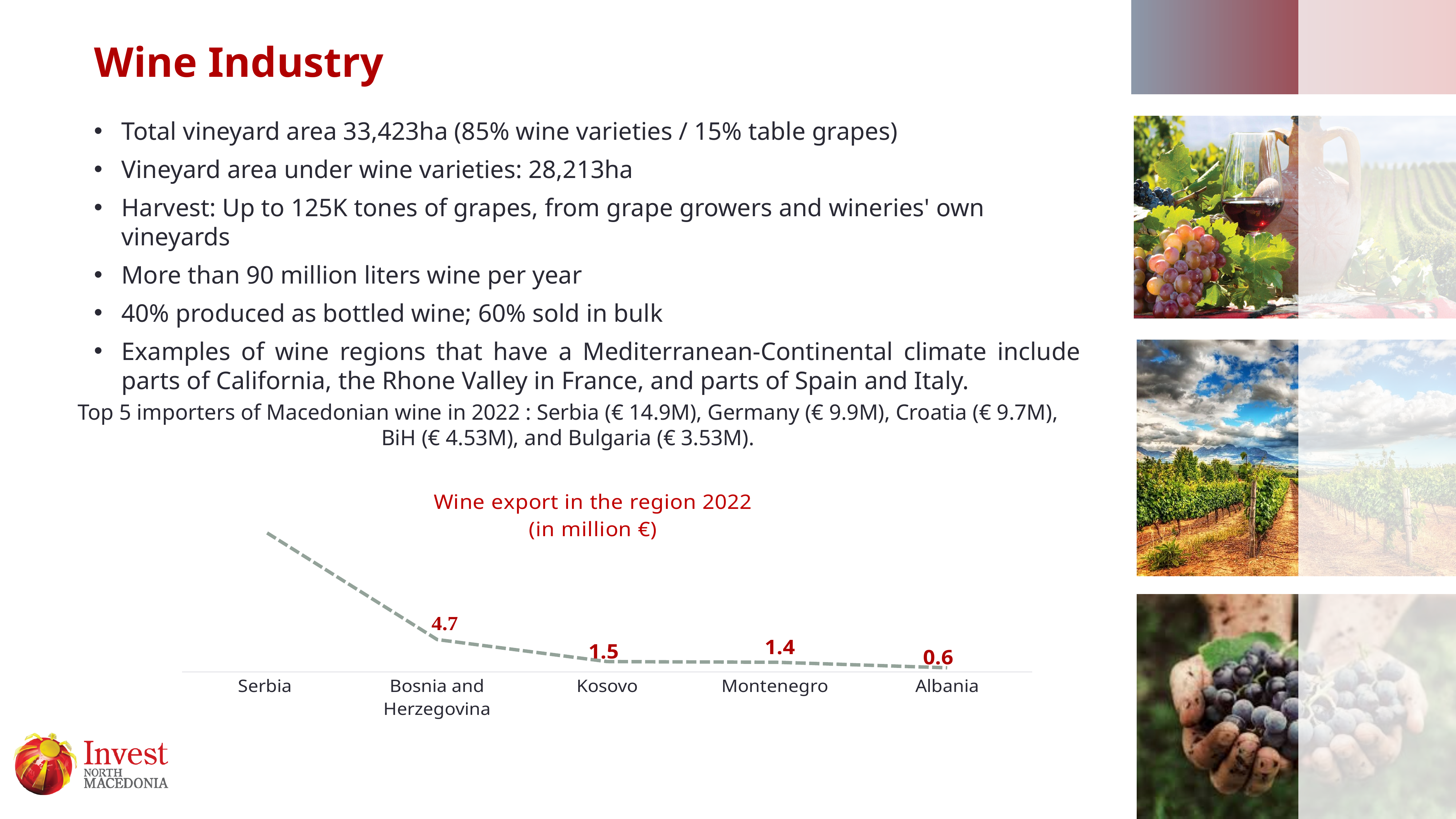
What is the difference between the wine export values for Bosnia and Herzegovina and Kosovo? 3.2 What is the wine export value for Bosnia and Herzegovina in the chart? 4.7 What is the wine export value for Kosovo in the chart? 1.5 What type of chart is shown under the title "Wine export in the region 2022"? line chart What is the wine export value for Montenegro in the chart? 1.4 Which has a larger wine export value in the chart, Kosovo or Montenegro? Kosovo What is the wine export value for Albania in the chart? 0.6 Which country has the highest wine export value in the chart? Serbia Do the values in the wine export chart generally rise or fall from Serbia to Albania? fall Which country has the lowest wine export value in the chart? Albania In what unit are the values in the wine export chart expressed, according to its title? million € How many countries are plotted in the wine export chart? 5